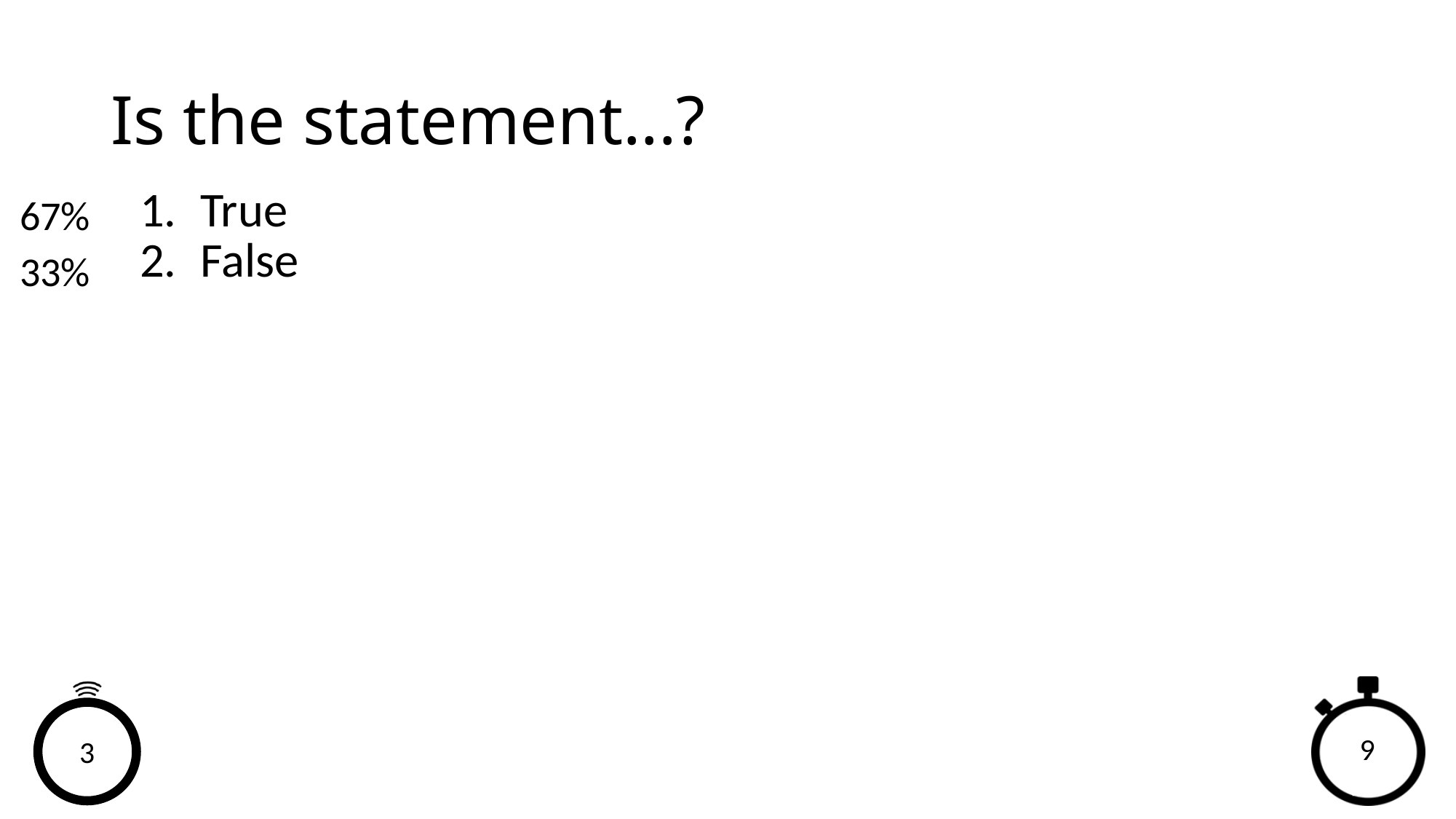
Is the percentage for True greater or less than 50%? greater Is the percentage for False larger or smaller than the percentage for True? smaller Which option has the higher percentage, True or False? True What percentage is shown for the option "True"? 67% What percentage is shown for the option "False"? 33% What is the title of the question on the slide? Is the statement…? Which option has the lower percentage? False What is the difference between the percentages for True and False? 34% How many answer options are listed on the slide? 2